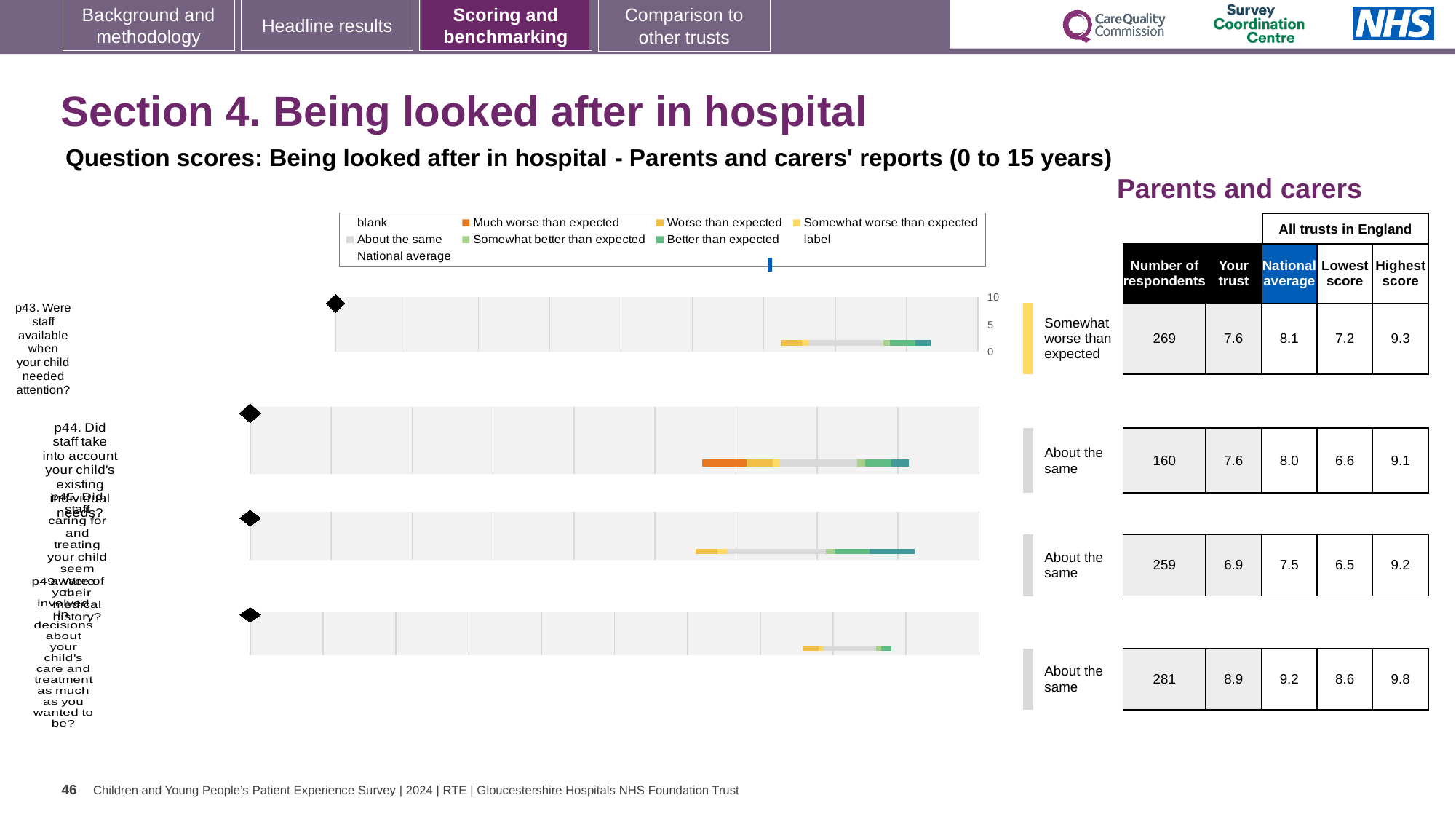
For the second chart (p44. Did staff take into account your child's existing individual needs?), what is the lowest score among all trusts in England? 6.6 For the first chart (p43. Were staff available when your child needed attention?), what is the national average? 8.1 For the first chart (p43), what is the difference between the national average and the 'Your trust' score? 0.5 How many question charts are shown on the slide? 4 What kind of chart is used to show the benchmark results for each question on this slide? bar chart According to the legend, what does the blue vertical marker represent? National average For the first chart (p43), which is larger: the 'Your trust' score or the national average? National average What rating category is given for the first chart (p43. Were staff available when your child needed attention?)? Somewhat worse than expected For the first chart (p43. Were staff available when your child needed attention?), what is the 'Your trust' score? 7.6 Which of the four charts has the highest 'Your trust' score? The fourth (bottom) chart, 8.9 For the first chart (p43. Were staff available when your child needed attention?), what is the highest score among all trusts in England? 9.3 For the first chart (p43. Were staff available when your child needed attention?), what is the number of respondents? 269